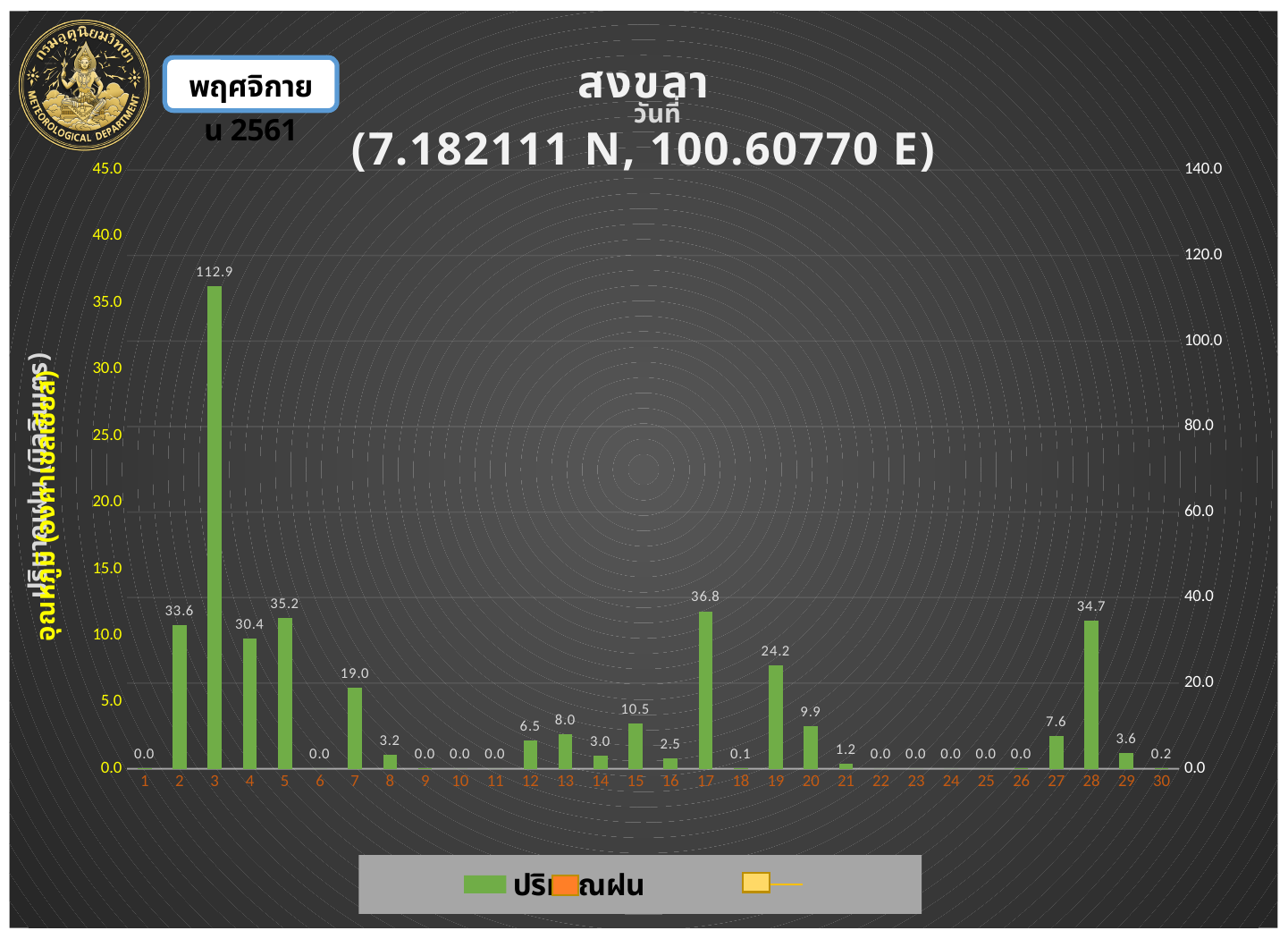
What is the rainfall value shown for day 17? 36.8 What is the rainfall value shown for day 28? 34.7 What coordinates are given in the chart title? 7.182111 N, 100.60770 E What kind of chart is shown on the slide? bar chart What is the rainfall value shown for day 3? 112.9 Which day has the highest rainfall value? 3 Which day has the larger rainfall value, day 2 or day 4? 2 How many days are shown on the x axis of the chart? 30 What is the difference between the rainfall values for day 3 and day 2? 79.3 What is the difference between the rainfall values for day 19 and day 20? 14.3 Which day has the larger rainfall value, day 7 or day 15? 7 What is the rainfall value shown for day 19? 24.2